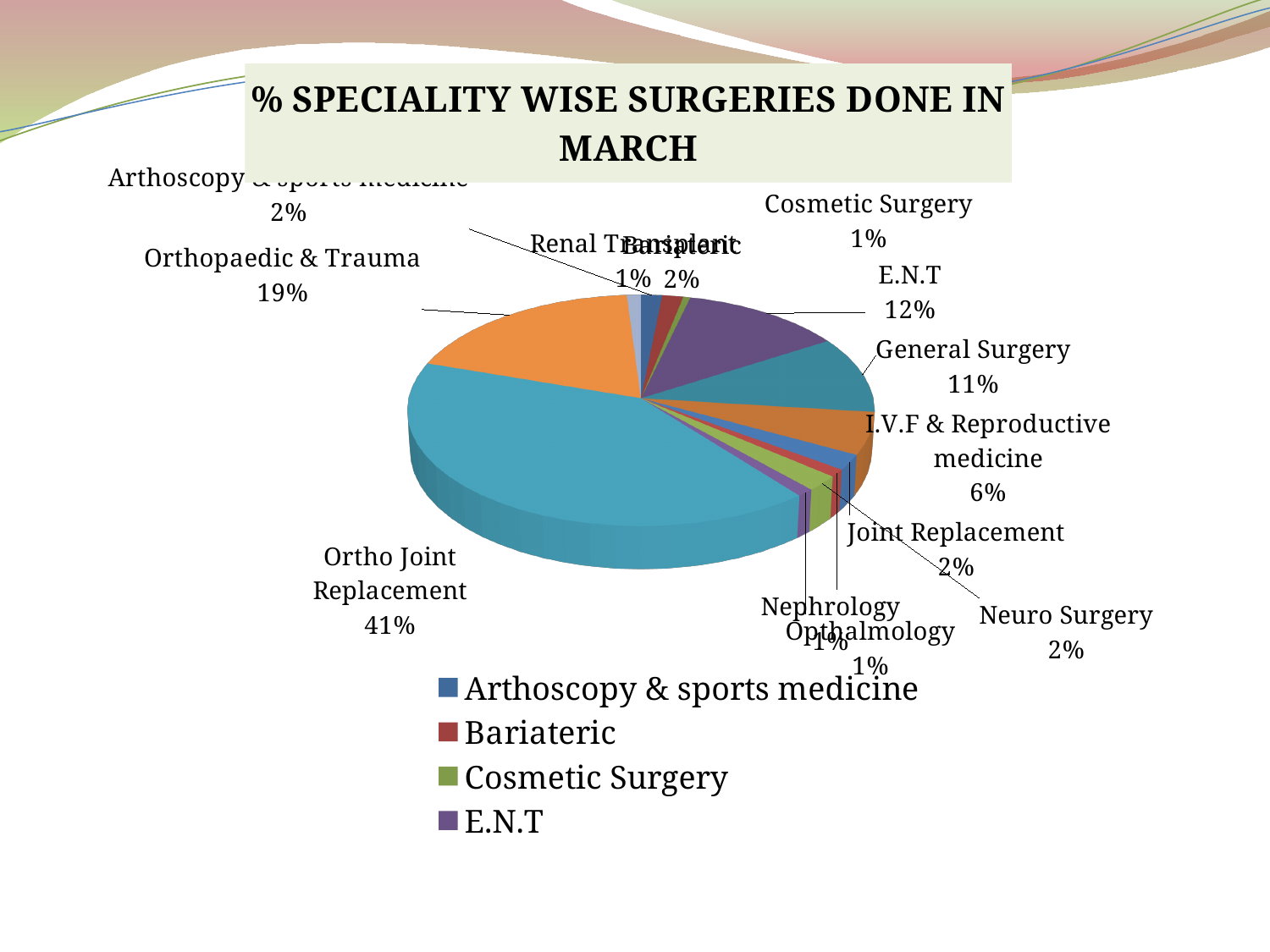
How many specialities (slices) are shown in the pie chart? 13 What percentage of surgeries were Neuro Surgery? 2% What percentage of surgeries were I.V.F & Reproductive medicine? 6% What percentage of surgeries were Ortho Joint Replacement? 41% What percentage of surgeries were E.N.T? 12% What percentage of surgeries were General Surgery? 11% What is the difference in percentage points between Ortho Joint Replacement and Orthopaedic & Trauma? 22 What percentage of surgeries were Orthopaedic & Trauma? 19% Which is larger, the share for E.N.T or the share for General Surgery? E.N.T Which speciality has the largest share of surgeries? Ortho Joint Replacement What is the title of the chart? % SPECIALITY WISE SURGERIES DONE IN MARCH What type of chart is shown on the slide? Pie chart